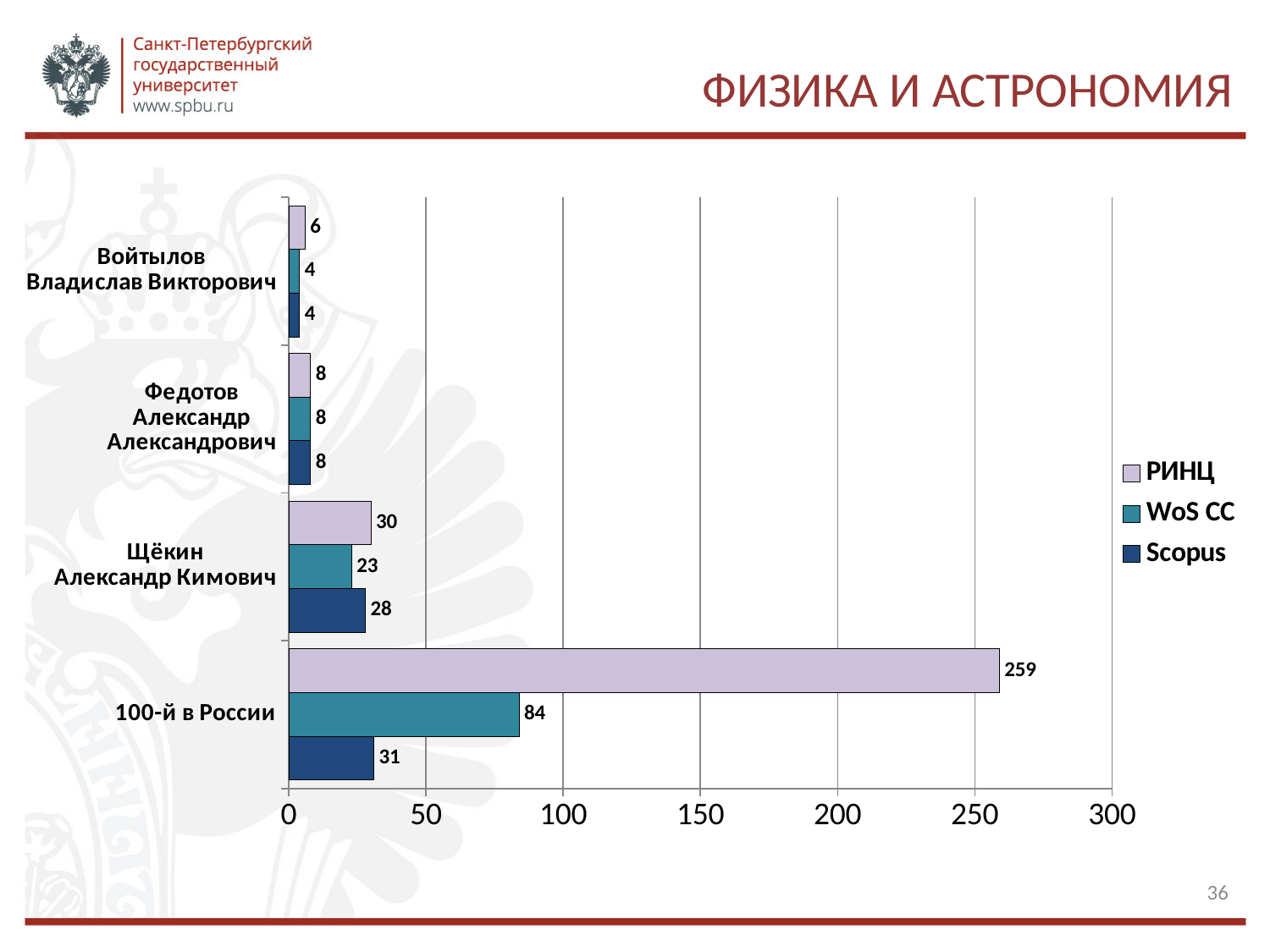
Which category has the highest Scopus value? 100-й в России How many series does the legend list? 3 Which is larger for Щёкин Александр Кимович: the РИНЦ value or the Scopus value? РИНЦ What kind of chart is shown on the slide? bar chart What is the РИНЦ value for 100-й в России? 259 Which category has the lowest WoS CC value? Войтылов Владислав Викторович What is the difference between the РИНЦ and WoS CC values for 100-й в России? 175 What is the title of the slide? ФИЗИКА И АСТРОНОМИЯ What is the WoS CC value for Щёкин Александр Кимович? 23 How many categories are shown on the chart? 4 What is the Scopus value for Федотов Александр Александрович? 8 What is the РИНЦ value for Войтылов Владислав Викторович? 6